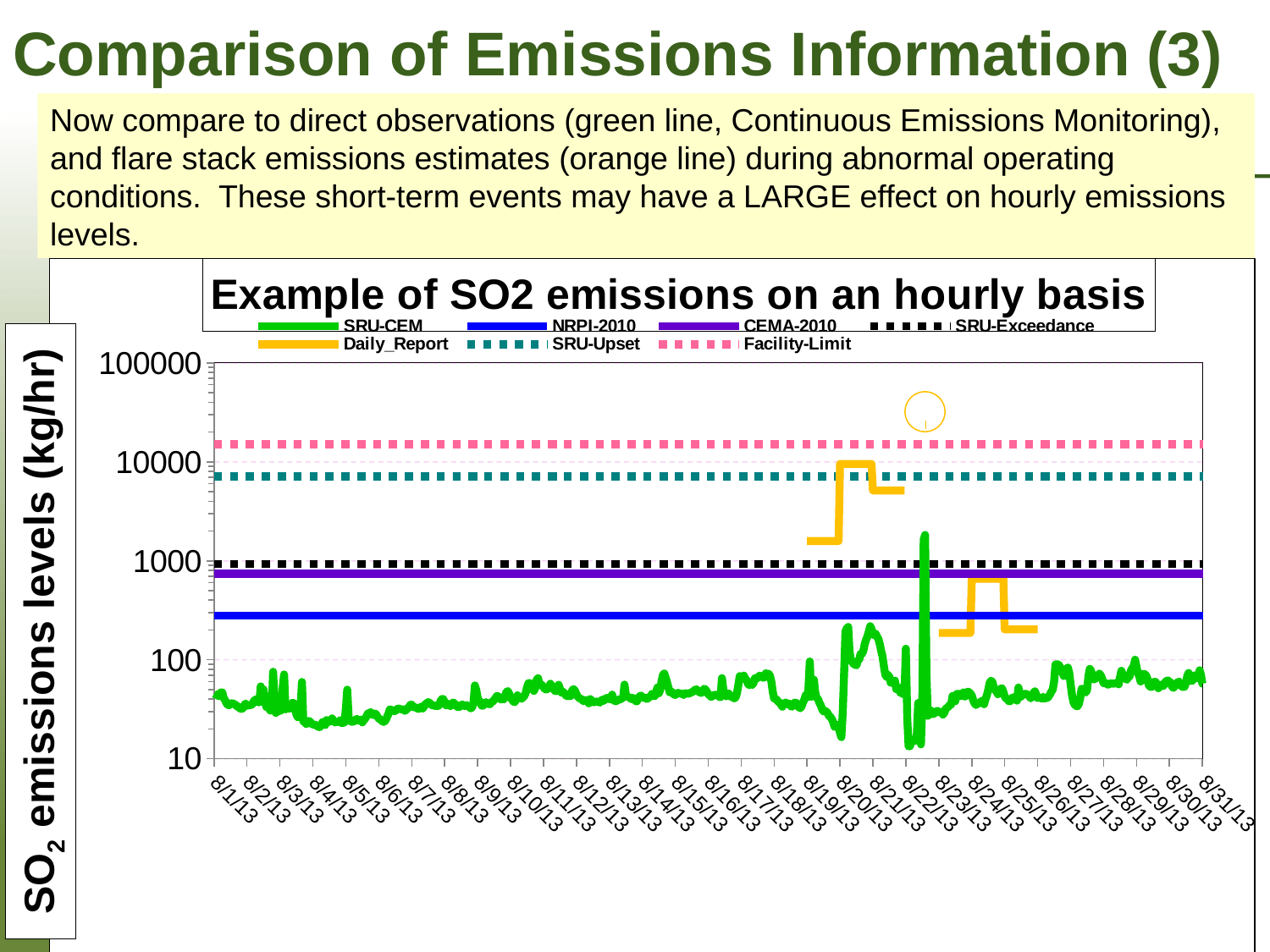
What is the title of the chart? Example of SO2 emissions on an hourly basis Is the value of the SRU-Upset line greater or less than 10000? less Which is higher on the chart, the Facility-Limit line or the SRU-Upset line? Facility-Limit Is the value of the Facility-Limit line greater or less than 10000? greater Is the value of the NRPI-2010 line greater or less than 1000? less What kind of chart is shown on the slide? line chart What is the label of the y axis? SO2 emissions levels (kg/hr) How many date labels are shown along the x axis? 31 How many series does the chart legend list? 7 Which of the horizontal reference lines is the lowest on the chart? NRPI-2010 Which is higher on the chart, the NRPI-2010 line or the CEMA-2010 line? CEMA-2010